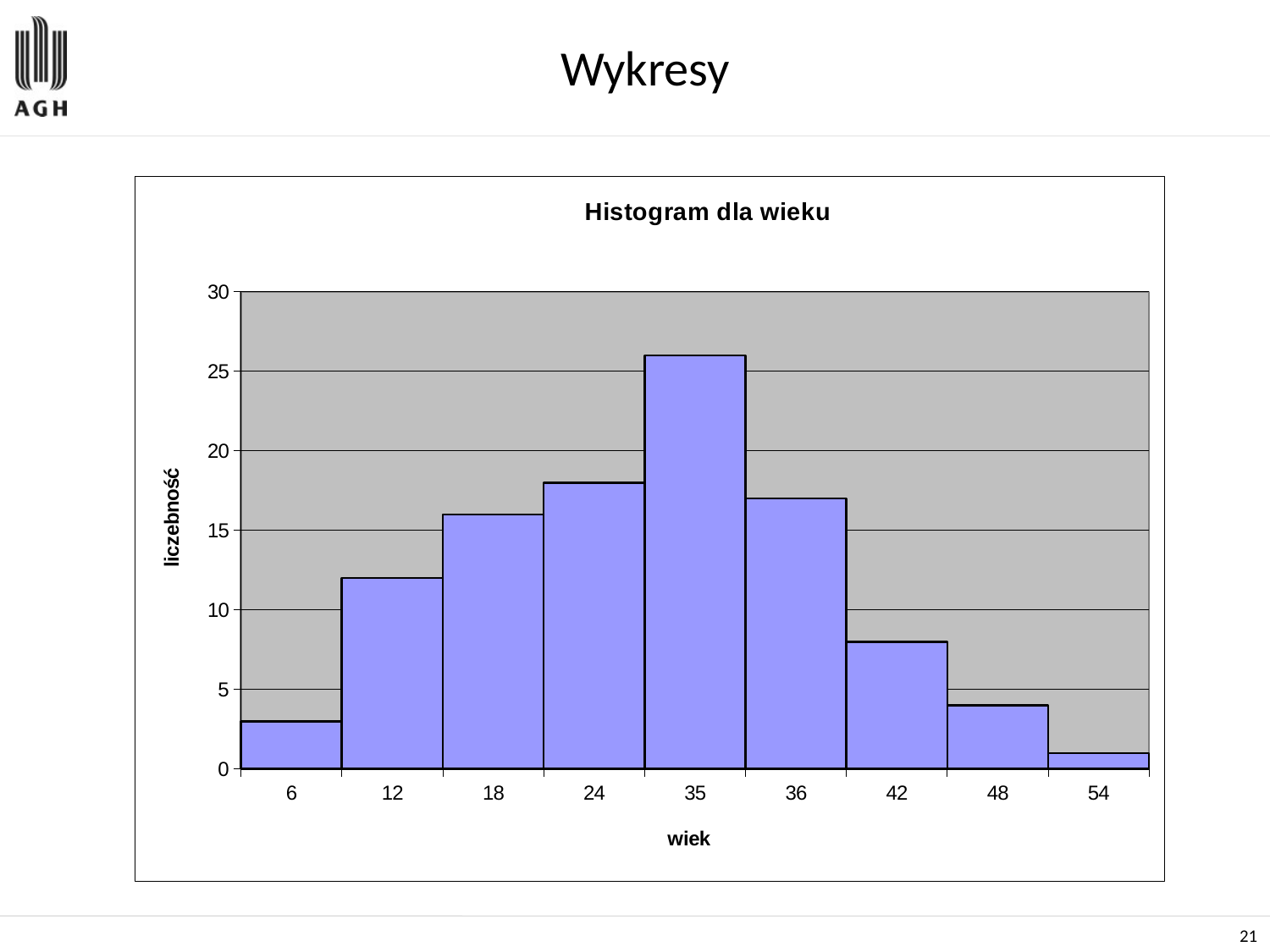
Which age category has the highest liczebność? 35 Which age category has the lowest liczebność? 54 Which has a larger value, 12 or 42? 12 What kind of chart is shown on the slide? bar chart Which has a larger value, 48 or 18? 18 How many bars are plotted in the chart? 9 Is the value for 42 greater or less than 10? less What is the label of the vertical axis? liczebność Is the value for 12 greater or less than 10? greater Is the value for 35 greater or less than 25? greater What is the title of the chart? Histogram dla wieku